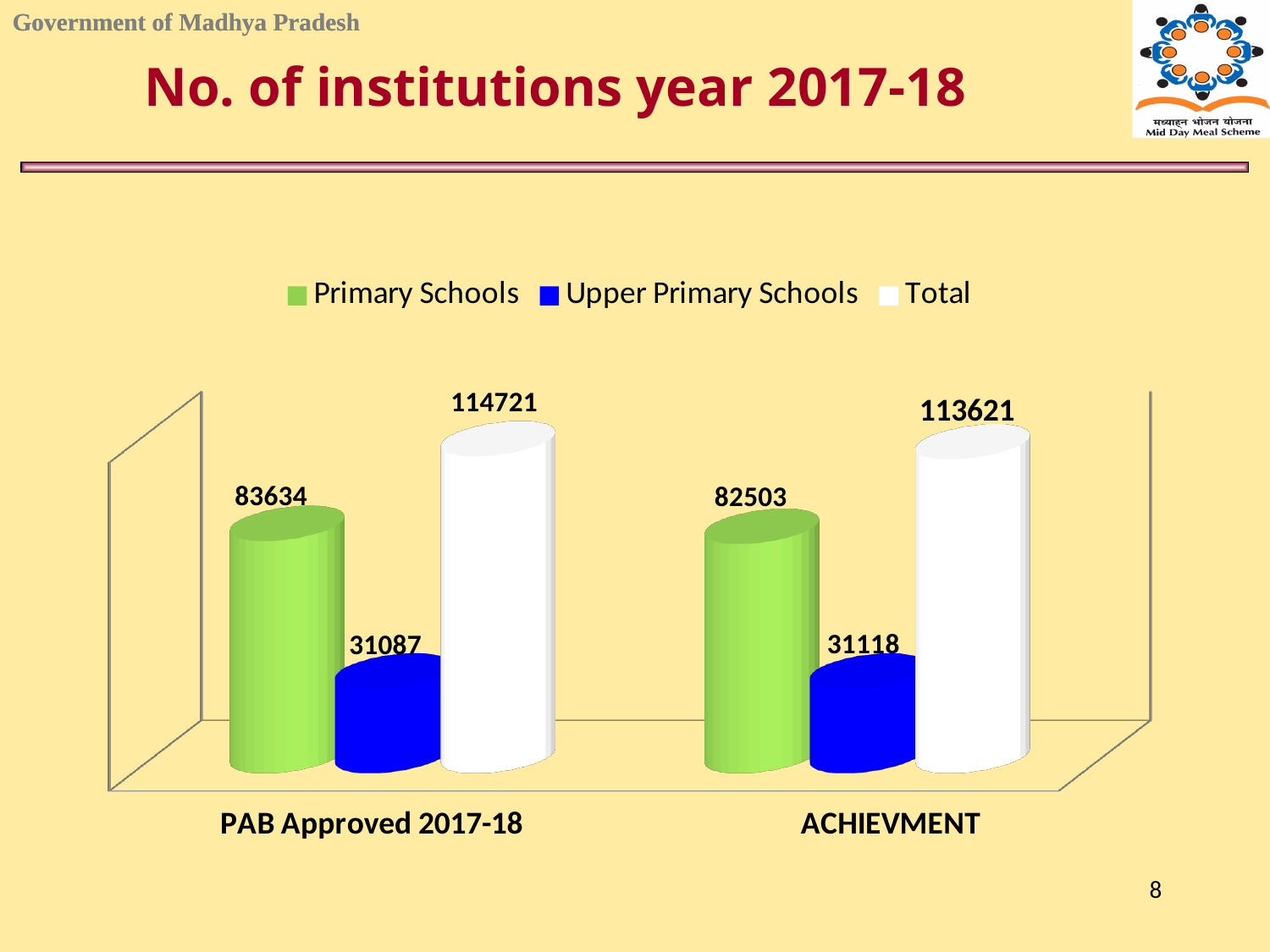
Which is larger: Primary Schools under PAB Approved 2017-18 or Primary Schools under ACHIEVMENT? PAB Approved 2017-18 What is the Total value for PAB Approved 2017-18? 114721 Which series has the lowest value under PAB Approved 2017-18? Upper Primary Schools What is the value for Primary Schools under ACHIEVMENT? 82503 What is the difference between the Total for PAB Approved 2017-18 and the Total for ACHIEVMENT? 1100 What is the value for Upper Primary Schools under ACHIEVMENT? 31118 Which series has the highest value under ACHIEVMENT? Total How many categories are shown on the x axis? 2 How many series does the legend list? 3 What is the value for Primary Schools under PAB Approved 2017-18? 83634 What kind of chart is shown on the slide? Bar chart What is the difference between Primary Schools and Upper Primary Schools under ACHIEVMENT? 51385